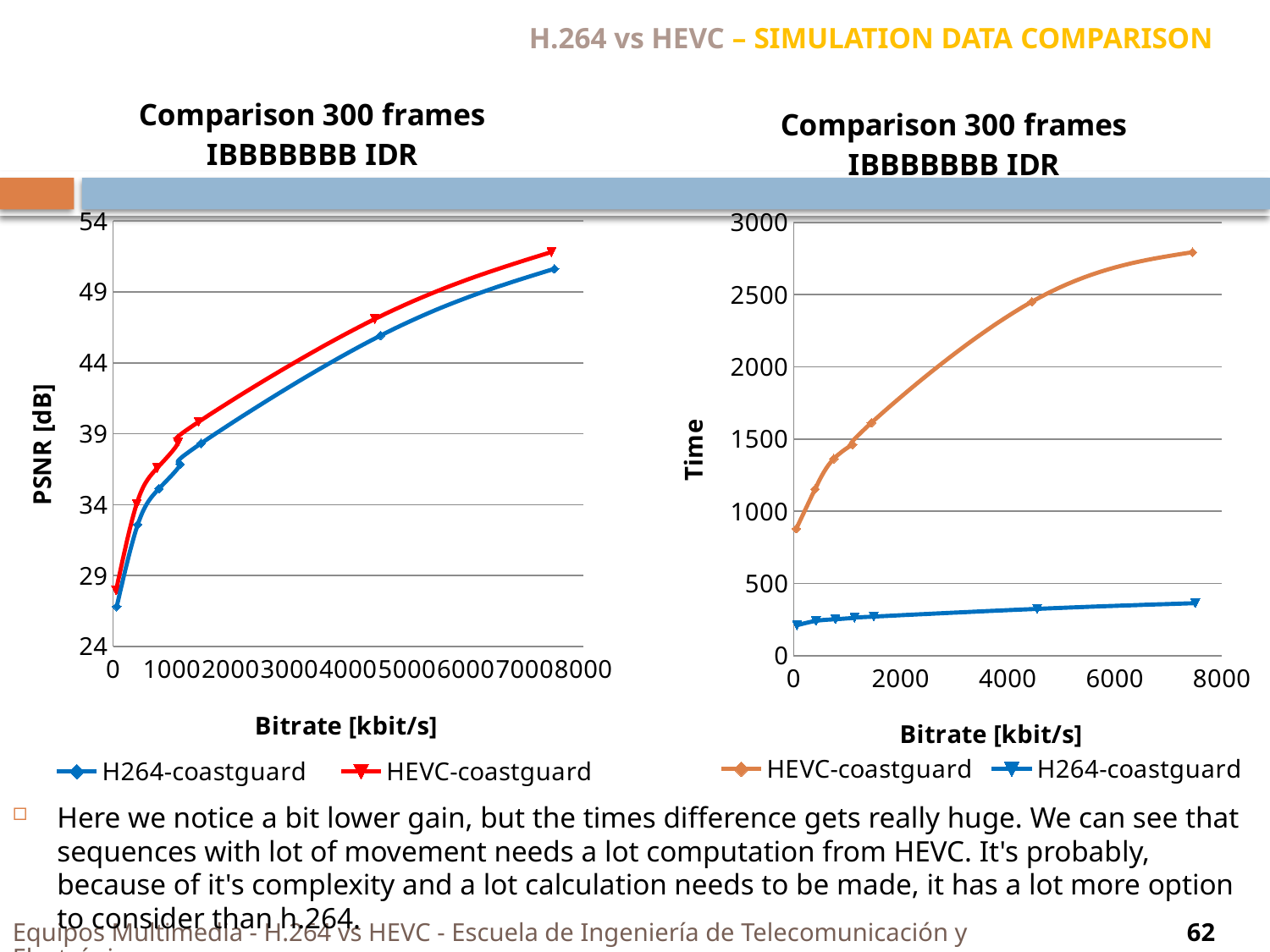
What is the y-axis label of the left chart? PSNR [dB] What kind of chart is the left chart (PSNR vs Bitrate)? line chart In the left chart, is the PSNR for HEVC-coastguard at the highest bitrate greater or less than 49? greater In the right chart, does the Time of HEVC-coastguard rise or fall as bitrate increases? rise How many series does the legend of the left chart list? 2 In the right chart, is the Time for HEVC-coastguard at the highest bitrate greater or less than 2500? greater What kind of chart is the right chart (Time vs Bitrate)? line chart In the right chart, which series has the higher Time at the highest bitrate, HEVC-coastguard or H264-coastguard? HEVC-coastguard How many series does the legend of the right chart list? 2 In the right chart, is the Time for H264-coastguard at the highest bitrate greater or less than 500? less In the left chart, does the PSNR of HEVC-coastguard rise or fall as bitrate increases? rise In the left chart, which series has the higher PSNR at the highest bitrate, H264-coastguard or HEVC-coastguard? HEVC-coastguard